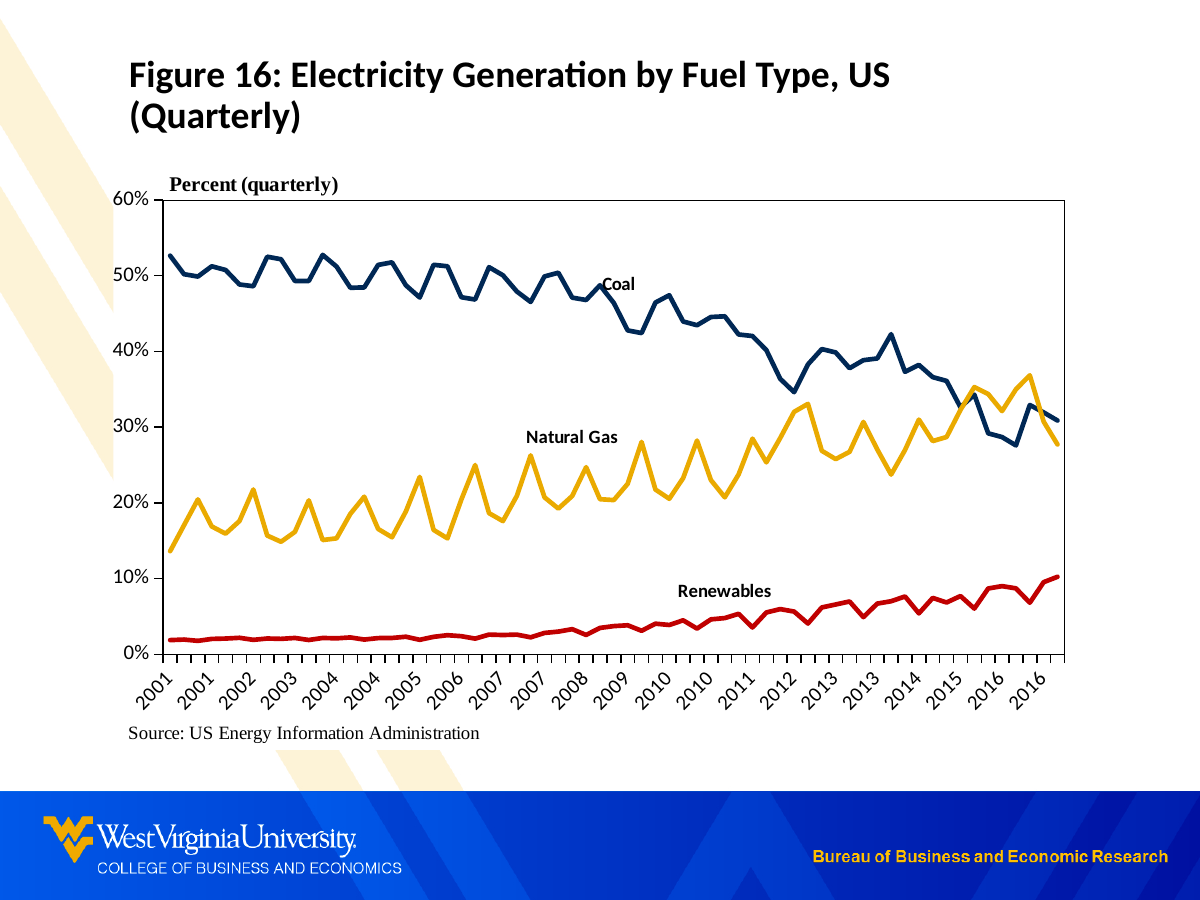
In 2001, which is larger: the Coal share or the Natural Gas share? Coal Does the Renewables share rise or fall overall from 2001 to 2016? rise Which fuel type has the highest share of electricity generation at the start of the series in 2001? Coal What kind of chart is shown on the slide? line chart What is the source cited below the chart? US Energy Information Administration Is the Renewables share in 2001 greater or less than 10%? less Is the Natural Gas share at the start of 2001 greater or less than 20%? less How many fuel-type series are plotted on the chart? 3 Does the Coal share rise or fall overall from 2001 to 2016? fall Is the Coal share at the end of 2016 greater or less than 40%? less Which fuel type has the lowest share of electricity generation throughout the period shown? Renewables